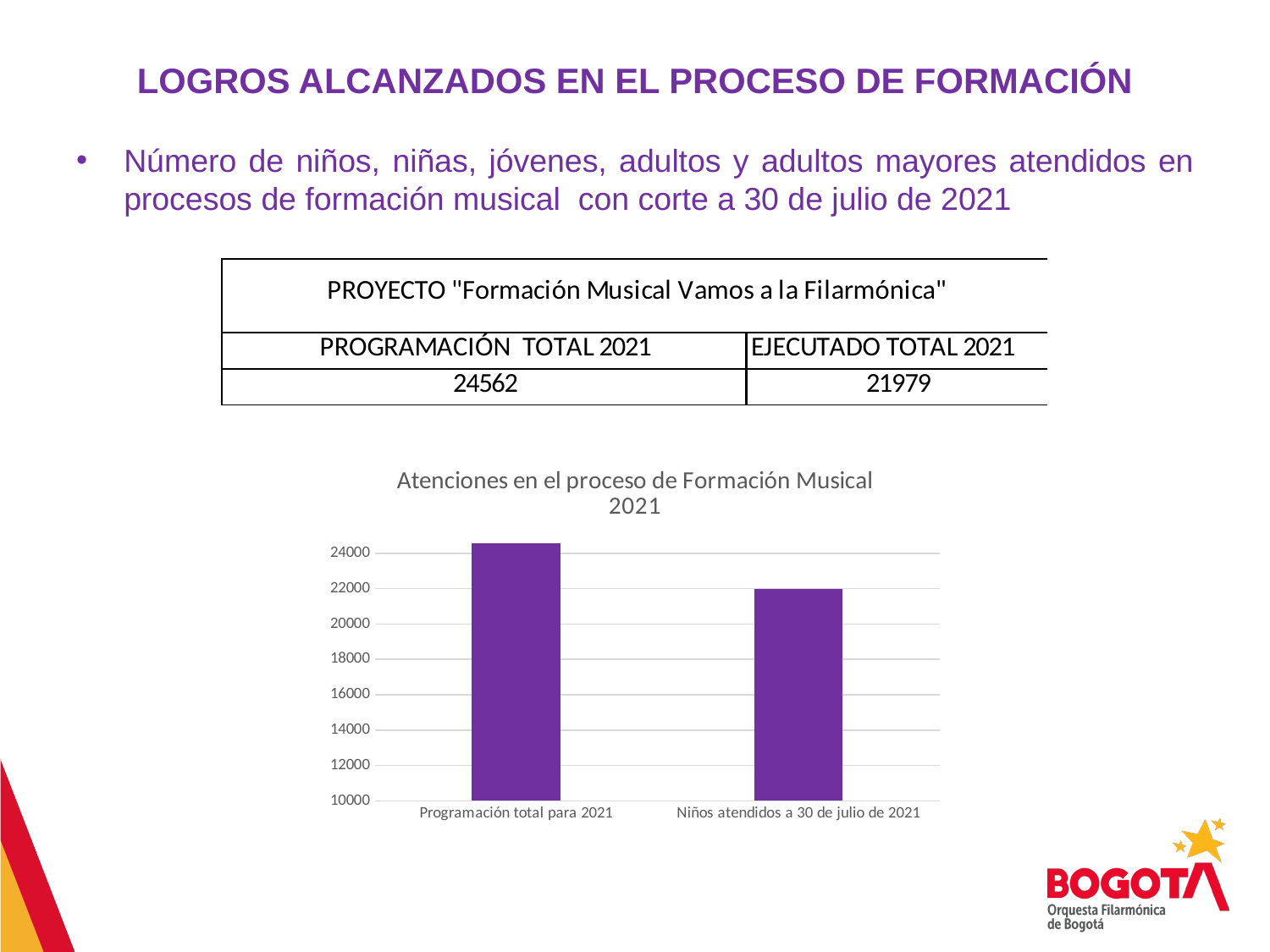
Is the value for Niños atendidos a 30 de julio de 2021 greater or less than 24000? less What kind of chart is shown on the slide? bar chart Is the value for Niños atendidos a 30 de julio de 2021 greater or less than 20000? greater Which is larger: the value for Programación total para 2021 or the value for Niños atendidos a 30 de julio de 2021? Programación total para 2021 Which category has the lowest value in the chart? Niños atendidos a 30 de julio de 2021 What colour are the bars in the chart? purple Do the values rise or fall from left to right across the chart? fall Is the value for Programación total para 2021 greater or less than 18000? greater Which category has the highest value in the chart? Programación total para 2021 What is the title of the chart? Atenciones en el proceso de Formación Musical 2021 How many bars are plotted in the chart? 2